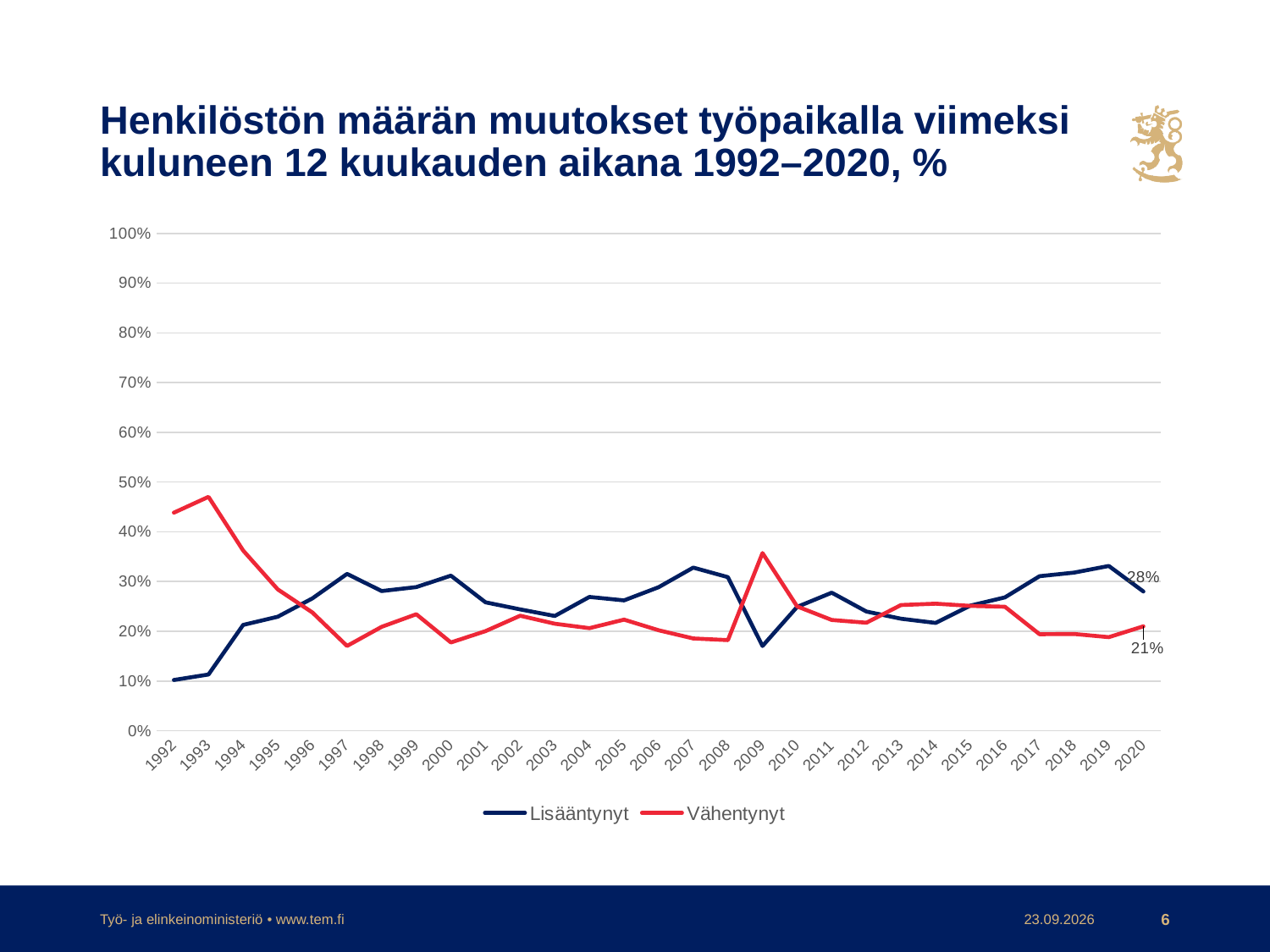
How many years are plotted along the x axis? 29 What is the value of Vähentynyt in 2020? 21% In 1992, which series has the higher value, Lisääntynyt or Vähentynyt? Vähentynyt Is the value for Lisääntynyt in 1992 greater or less than 20%? less Does the Lisääntynyt line rise or fall from 1992 to 1997? rise In 2020, which series has the higher value, Lisääntynyt or Vähentynyt? Lisääntynyt What is the difference between Lisääntynyt and Vähentynyt in 2020? 7 percentage points What kind of chart is shown on the slide? line chart Is the value for Vähentynyt in 1993 greater or less than 40%? greater How many series does the legend list? 2 What is the value of Lisääntynyt in 2020? 28% Is the value for Vähentynyt in 2009 greater or less than 30%? greater